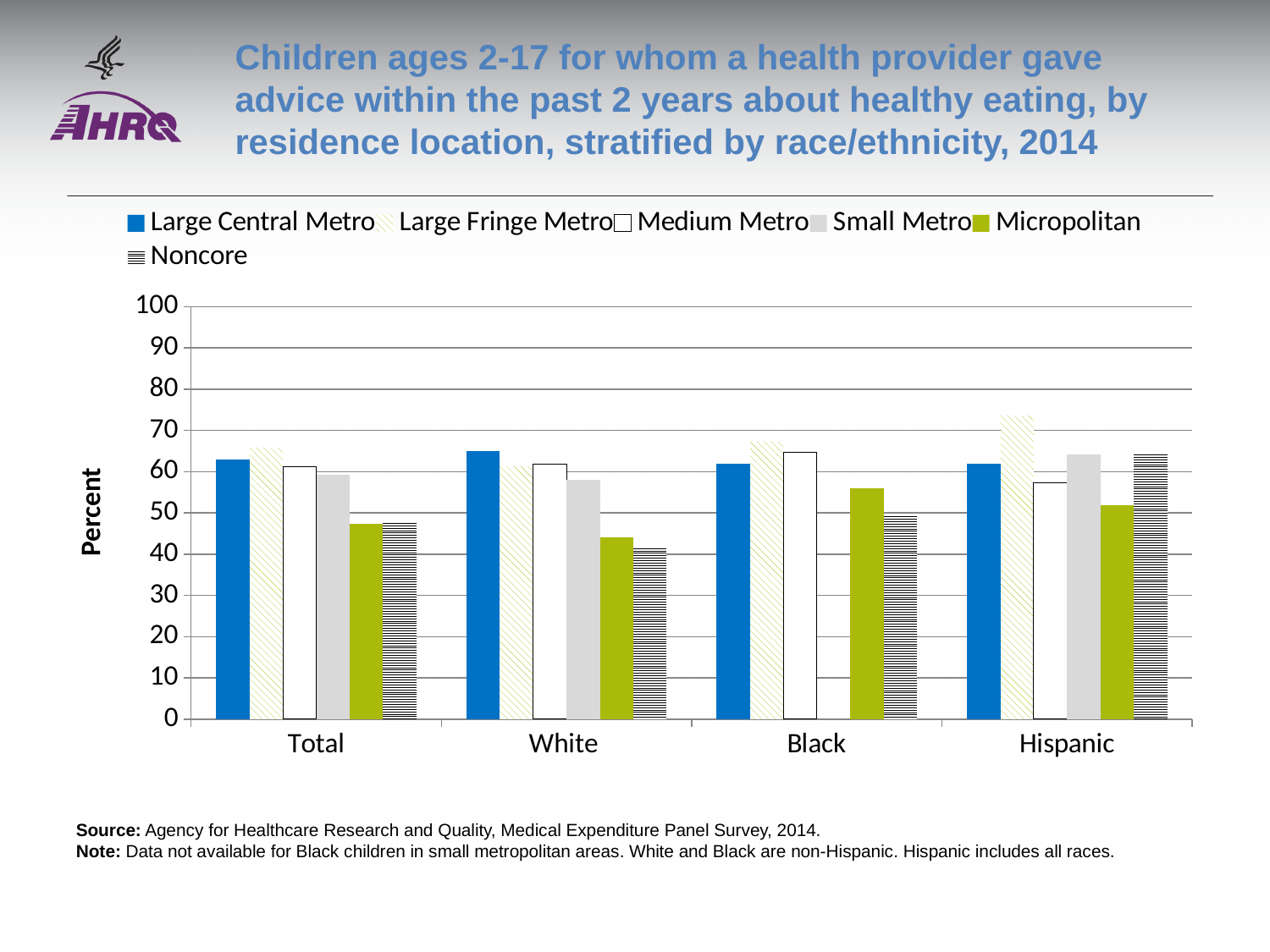
How many series does the legend list? 6 Which residence location has the highest value for Hispanic children? Large Fringe Metro What kind of chart is shown on the slide? bar chart For the Total group, which is larger: Large Central Metro or Micropolitan? Large Central Metro What is the label on the y axis? Percent For Hispanic children, which is larger: Large Fringe Metro or Medium Metro? Large Fringe Metro Is the Large Fringe Metro value for Hispanic children greater or less than 70? greater Is the Micropolitan value for Black children greater or less than 60? less Which residence location has the lowest value for Black children? Noncore For which race/ethnicity group is the Small Metro bar missing? Black Is the Micropolitan value for White children greater or less than 50? less How many race/ethnicity categories are shown on the x axis? 4